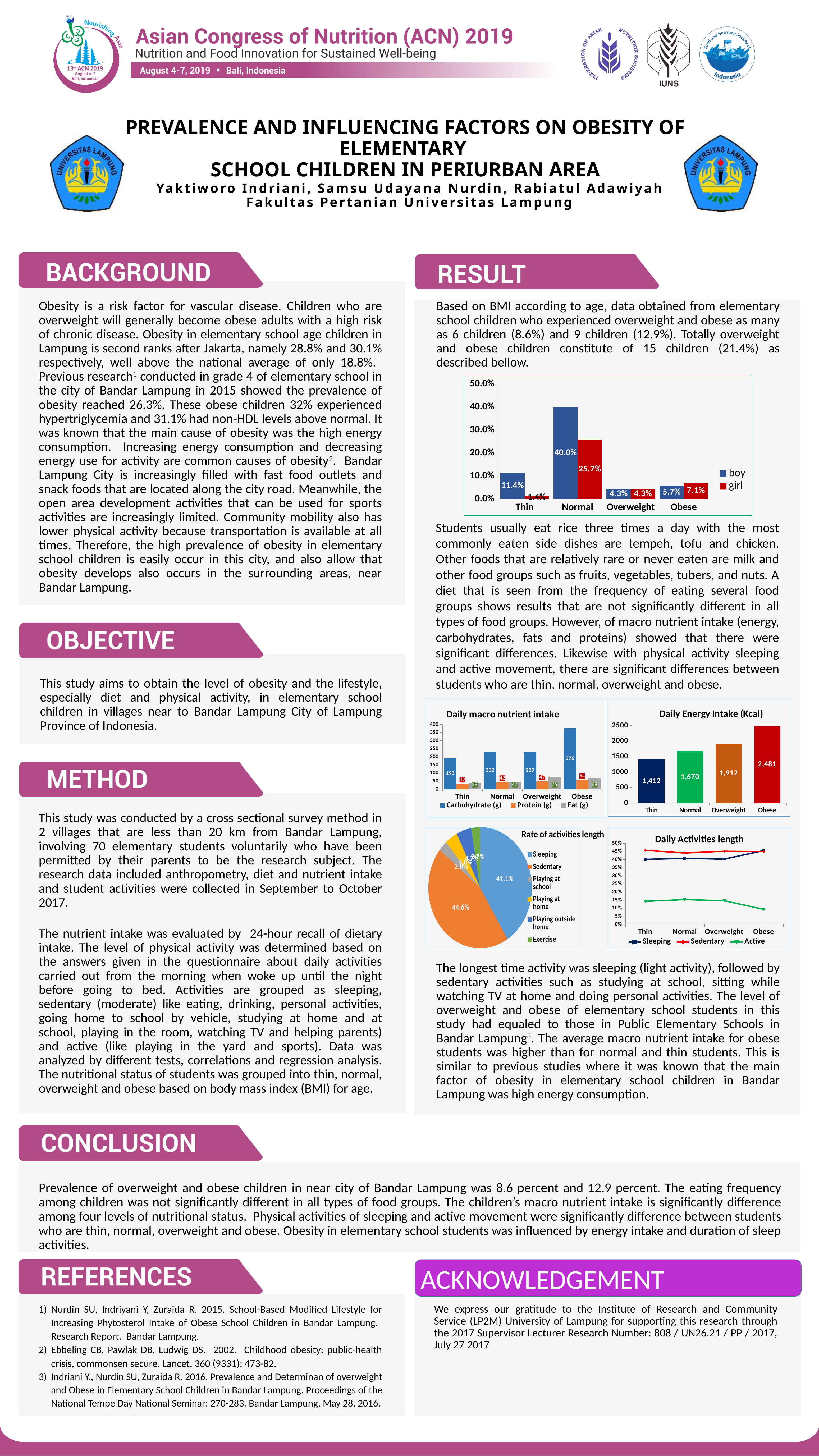
In the 'Daily Energy Intake (Kcal)' chart, what is the value for Overweight? 1,912 In the 'Rate of activities length' pie chart, what share does Sedentary have? 44.6% In the boy/girl BMI bar chart at the top of the Result section, what is the value for boys in the Normal category? 40.0% In the 'Daily Energy Intake (Kcal)' chart, what is the difference between the Obese and Thin values? 1,069 In the 'Daily macro nutrient intake' chart, what is the Protein (g) value for Normal students? 42 In the 'Daily macro nutrient intake' chart, which category has the highest Fat (g) value? Overweight In the 'Daily Energy Intake (Kcal)' chart, do the values rise or fall from Thin to Obese? rise In the 'Daily Activities length' line chart, is the Active value for Thin greater or less than 10%? greater In the boy/girl BMI bar chart at the top of the Result section, how many series does the legend list? 2 In the 'Daily macro nutrient intake' chart, what is the Carbohydrate (g) value for Obese students? 376 In the boy/girl BMI bar chart at the top of the Result section, what is the difference between the boy and girl values for the Thin category? 10.0% In the boy/girl BMI bar chart at the top of the Result section, what is the value for girls in the Obese category? 7.1%